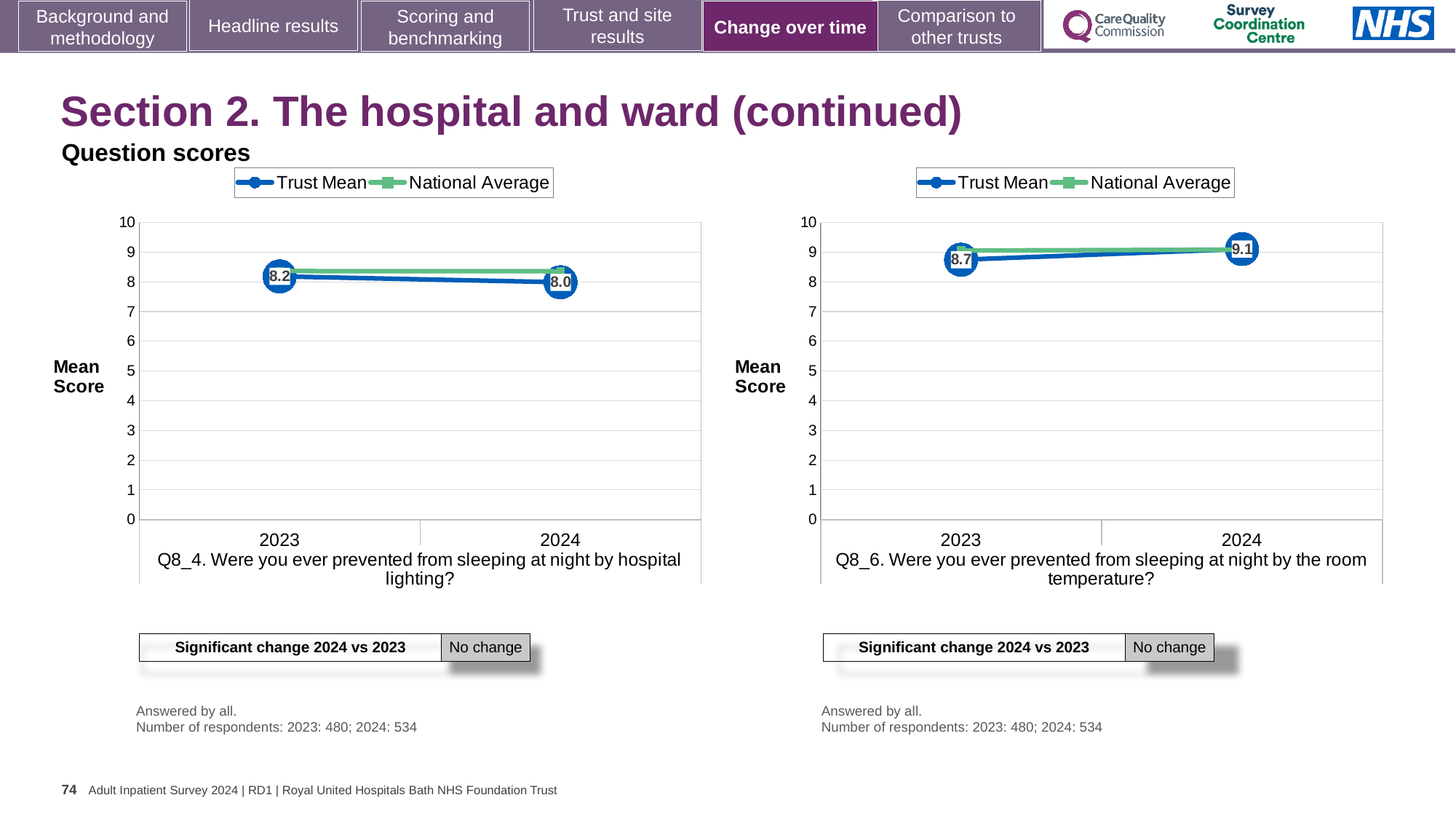
In the left chart (Q8_4, hospital lighting), what is the Trust Mean score for 2023? 8.2 In the left chart (Q8_4, hospital lighting), does the Trust Mean rise or fall from 2023 to 2024? fall In the left chart (Q8_4, hospital lighting), what is the Trust Mean score for 2024? 8.0 In the left chart (Q8_4, hospital lighting), is the National Average for 2024 greater or less than 8? greater In the right chart (Q8_6, room temperature), which year has the higher Trust Mean, 2023 or 2024? 2024 In the right chart (Q8_6, room temperature), by how much did the Trust Mean change from 2023 to 2024? 0.4 In the right chart (Q8_6, room temperature), does the Trust Mean rise or fall from 2023 to 2024? rise What type of chart is used on the right (Q8_6, room temperature)? line chart How many series does the legend of the left chart list? 2 In the right chart (Q8_6, room temperature), what is the Trust Mean score for 2024? 9.1 In the right chart (Q8_6, room temperature), what is the Trust Mean score for 2023? 8.7 In the left chart (Q8_4, hospital lighting), what is the difference between the Trust Mean for 2023 and 2024? 0.2